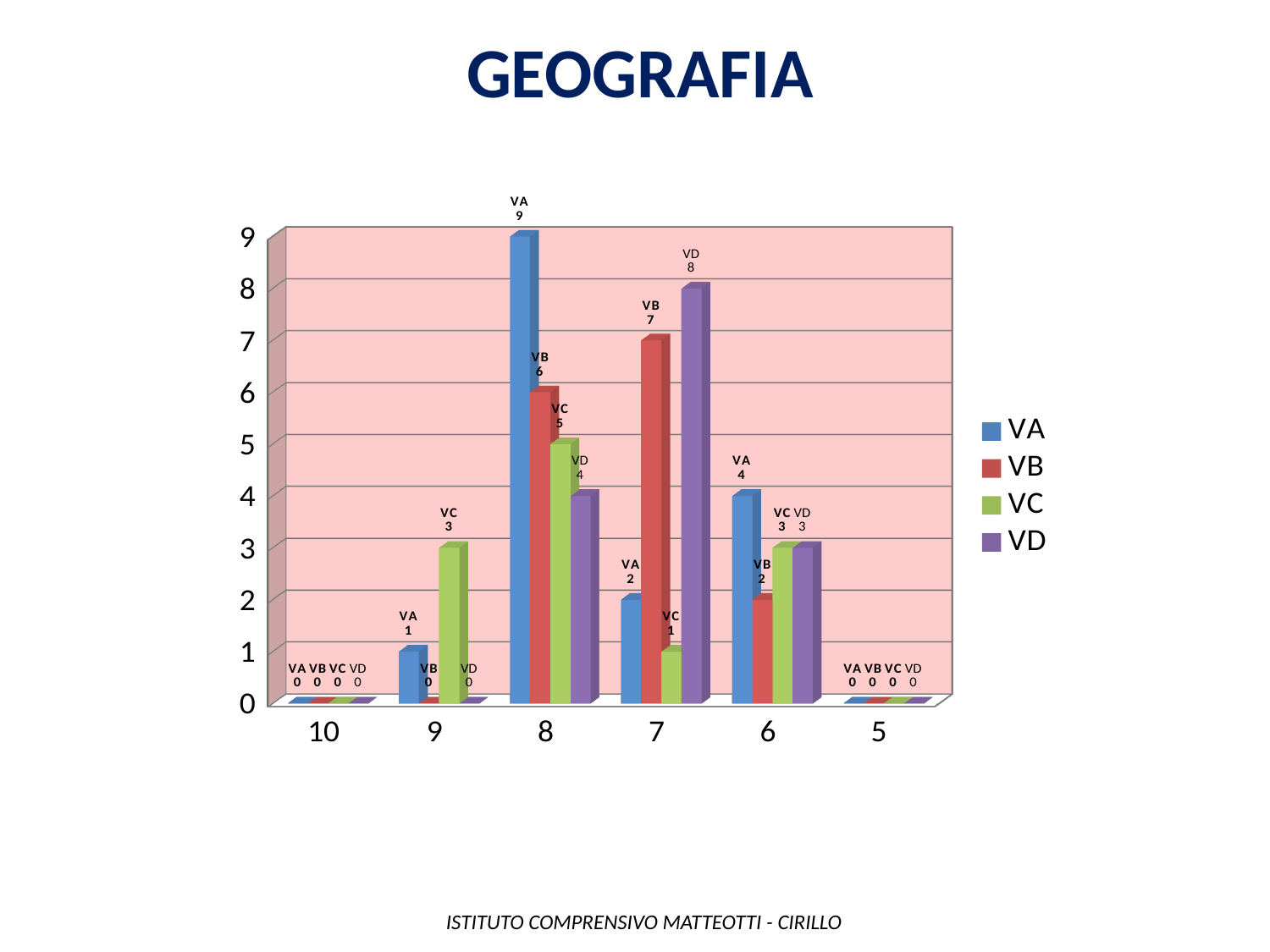
What is the title of the chart? GEOGRAFIA Which is larger at grade 6: VA or VC? VA How many grade categories are shown on the x axis? 6 Which series has the highest value at grade 7? VD How many series does the legend list? 4 What is the value for VC at grade 9? 3 What is the value for VB at grade 6? 2 What is the value for VD at grade 7? 8 Which series has the lowest value at grade 8? VD What kind of chart is shown on the slide? bar chart What is the difference between VA and VB at grade 8? 3 What is the value for VA at grade 8? 9